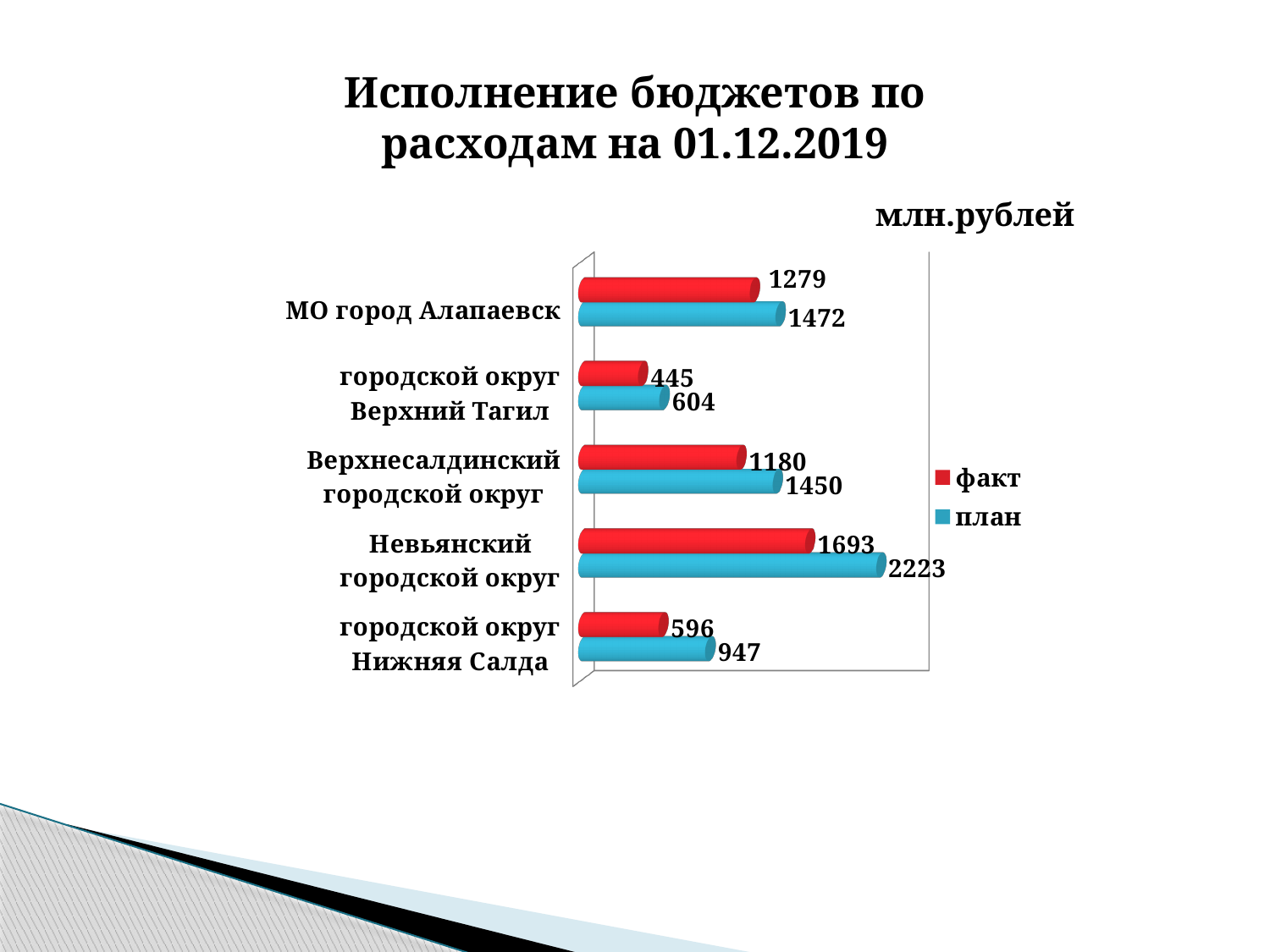
What is the 'план' value for городской округ Верхний Тагил? 604 Which category has the lowest 'факт' value? городской округ Верхний Тагил Which is larger for МО город Алапаевск: the 'факт' value or the 'план' value? план What is the 'факт' value for городской округ Нижняя Салда? 596 What kind of chart is shown on the slide? bar chart What is the 'план' value for Невьянский городской округ? 2223 What is the 'факт' value for МО город Алапаевск? 1279 Which category has the highest 'план' value? Невьянский городской округ How many series does the legend list? 2 How many categories are shown in the chart? 5 What is the difference between the 'план' and 'факт' values for Верхнесалдинский городской округ? 270 What unit is indicated above the chart? млн.рублей